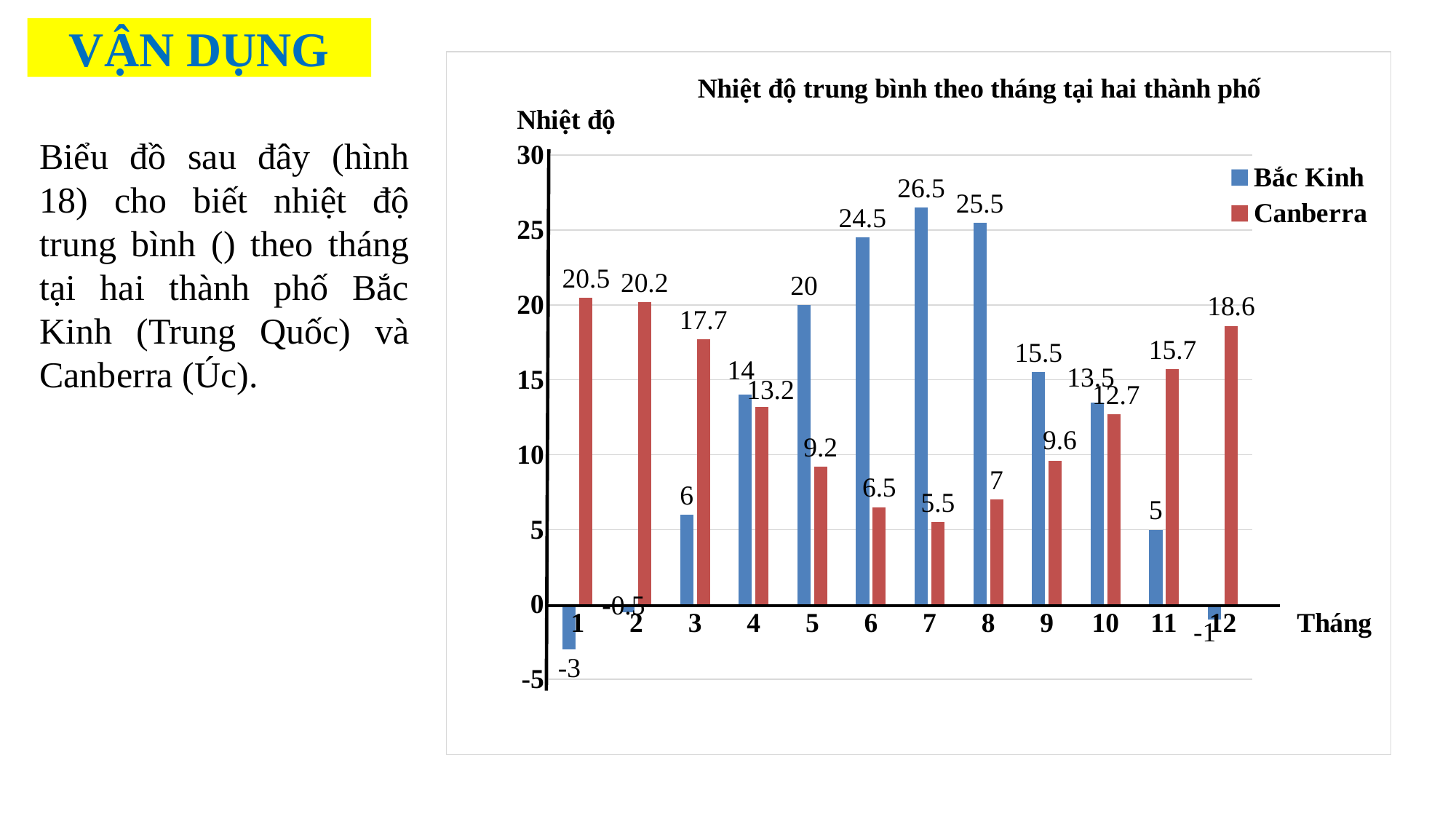
How many series does the legend list? 2 Which series is shown in red? Canberra What is the value for Canberra in month 1? 20.5 What is the difference between the Bắc Kinh and Canberra values in month 6? 18 What is the title of the chart? Nhiệt độ trung bình theo tháng tại hai thành phố Which is larger in month 11, the Bắc Kinh value or the Canberra value? Canberra In which month is the Bắc Kinh value highest? 7 What is the value for Bắc Kinh in month 1? -3 What type of chart is shown on the slide? bar chart In which month is the Canberra value lowest? 7 How many months are shown on the x axis? 12 What is the value for Bắc Kinh in month 7? 26.5